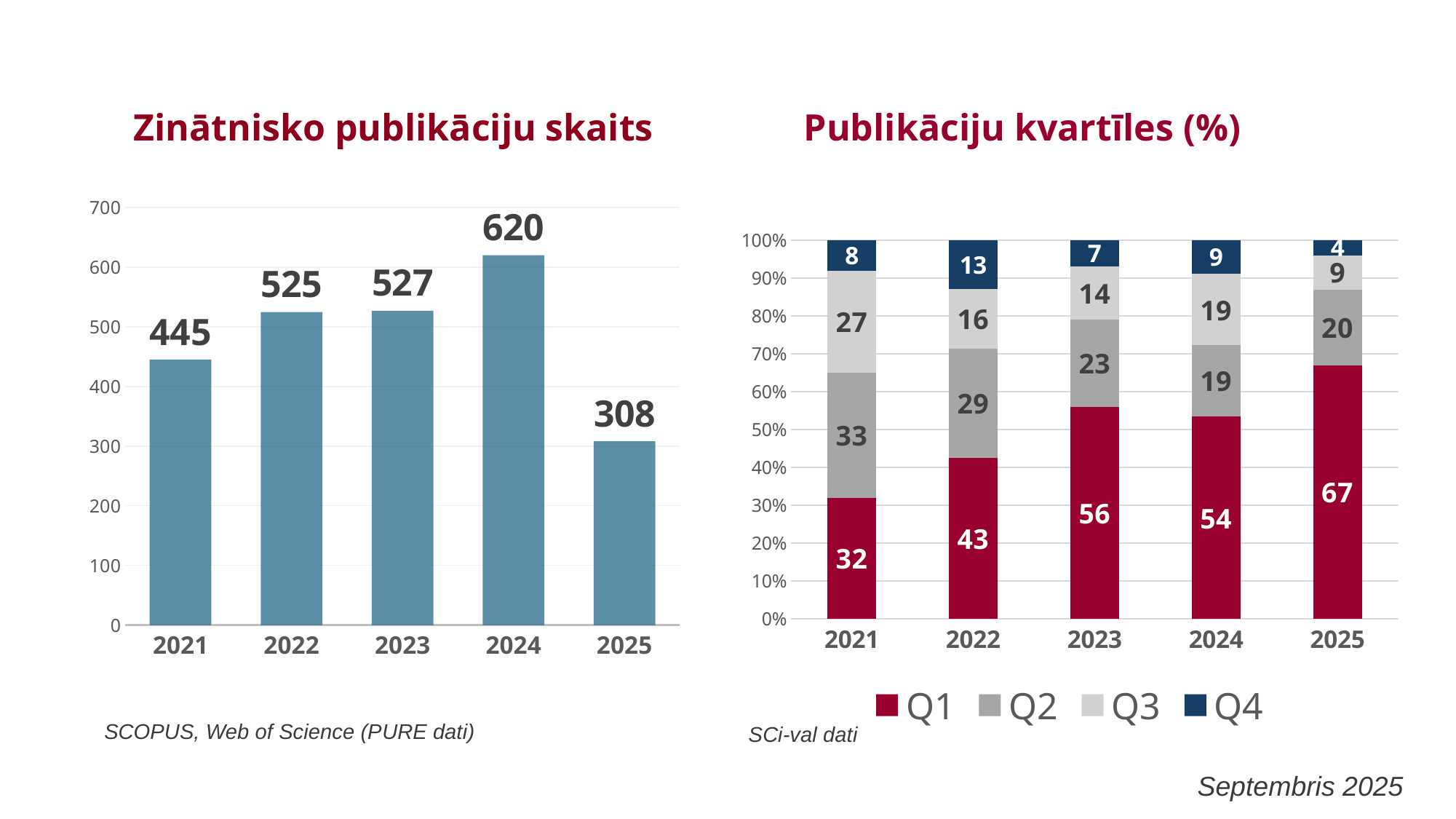
In the 'Zinātnisko publikāciju skaits' chart, what is the value for 2024? 620 In the 'Zinātnisko publikāciju skaits' chart, is the value for 2022 greater or less than 500? greater In the 'Publikāciju kvartīles (%)' chart, does the Q1 share rise or fall from 2021 to 2025? rise In the 'Zinātnisko publikāciju skaits' chart, which year has the lowest value? 2025 What kind of chart is 'Publikāciju kvartīles (%)'? stacked bar chart In the 'Publikāciju kvartīles (%)' chart, which is larger: the Q2 value for 2021 or the Q2 value for 2025? 2021 In the 'Zinātnisko publikāciju skaits' chart, how many years are shown on the x axis? 5 In the 'Publikāciju kvartīles (%)' chart, what is the Q3 value for 2021? 27 In the 'Publikāciju kvartīles (%)' chart, what is the Q1 value for 2025? 67 In the 'Publikāciju kvartīles (%)' chart, how many series does the legend list? 4 In the 'Zinātnisko publikāciju skaits' chart, which year has the highest value? 2024 In the 'Zinātnisko publikāciju skaits' chart, what is the difference between the values for 2024 and 2021? 175